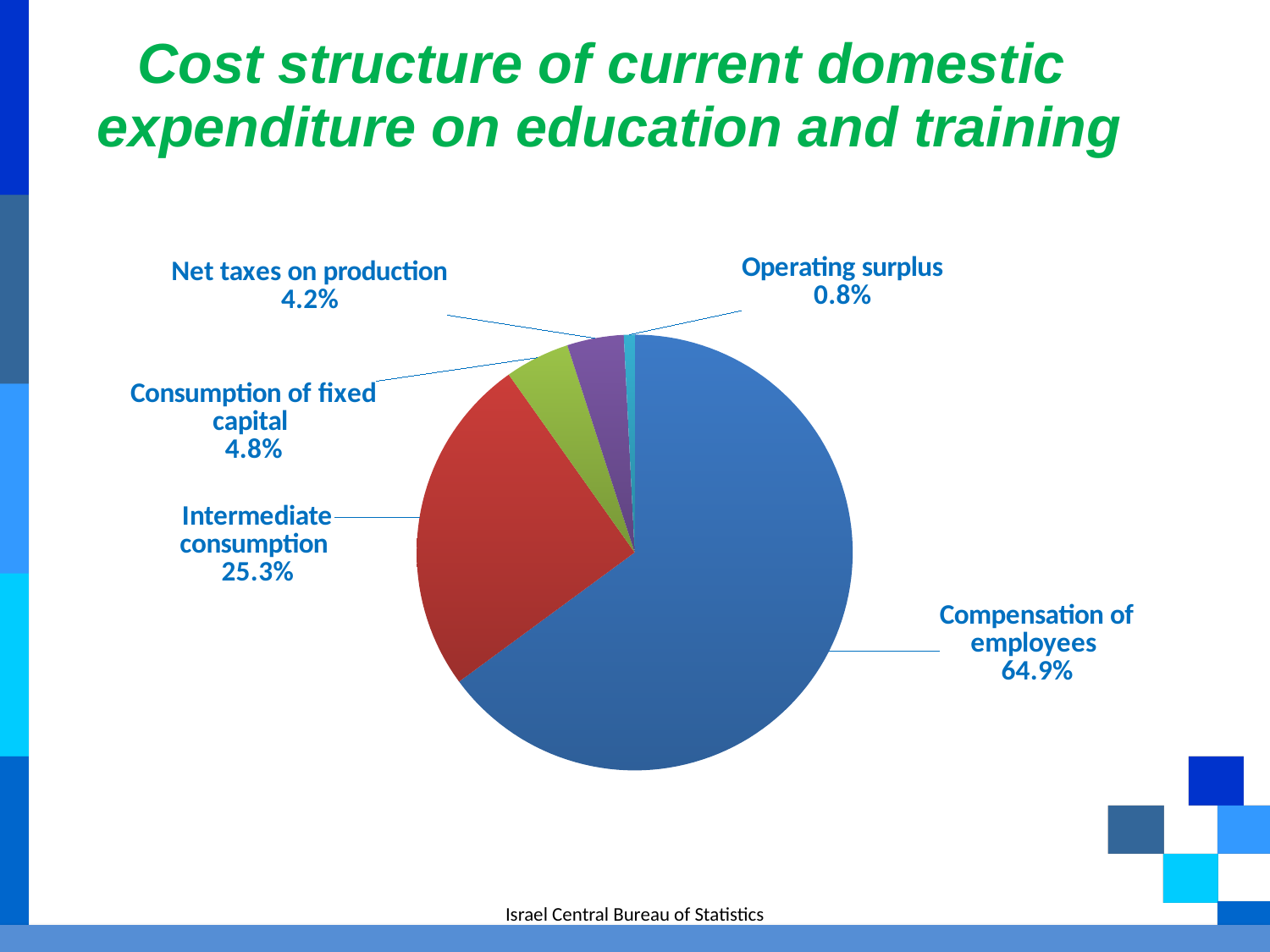
What is the value shown for Net taxes on production? 4.2% What is the value shown for Operating surplus? 0.8% Which is larger, Consumption of fixed capital or Net taxes on production? Consumption of fixed capital Which category has the smallest slice of the pie? Operating surplus What kind of chart is shown on the slide? Pie chart Which category has the largest slice of the pie? Compensation of employees What is the title of the chart on the slide? Cost structure of current domestic expenditure on education and training What is the value shown for Consumption of fixed capital? 4.8% What is the value shown for Intermediate consumption? 25.3% What is the difference between the shares of Compensation of employees and Intermediate consumption? 39.6% How many categories are shown in the pie chart? 5 What share of the pie is Compensation of employees? 64.9%